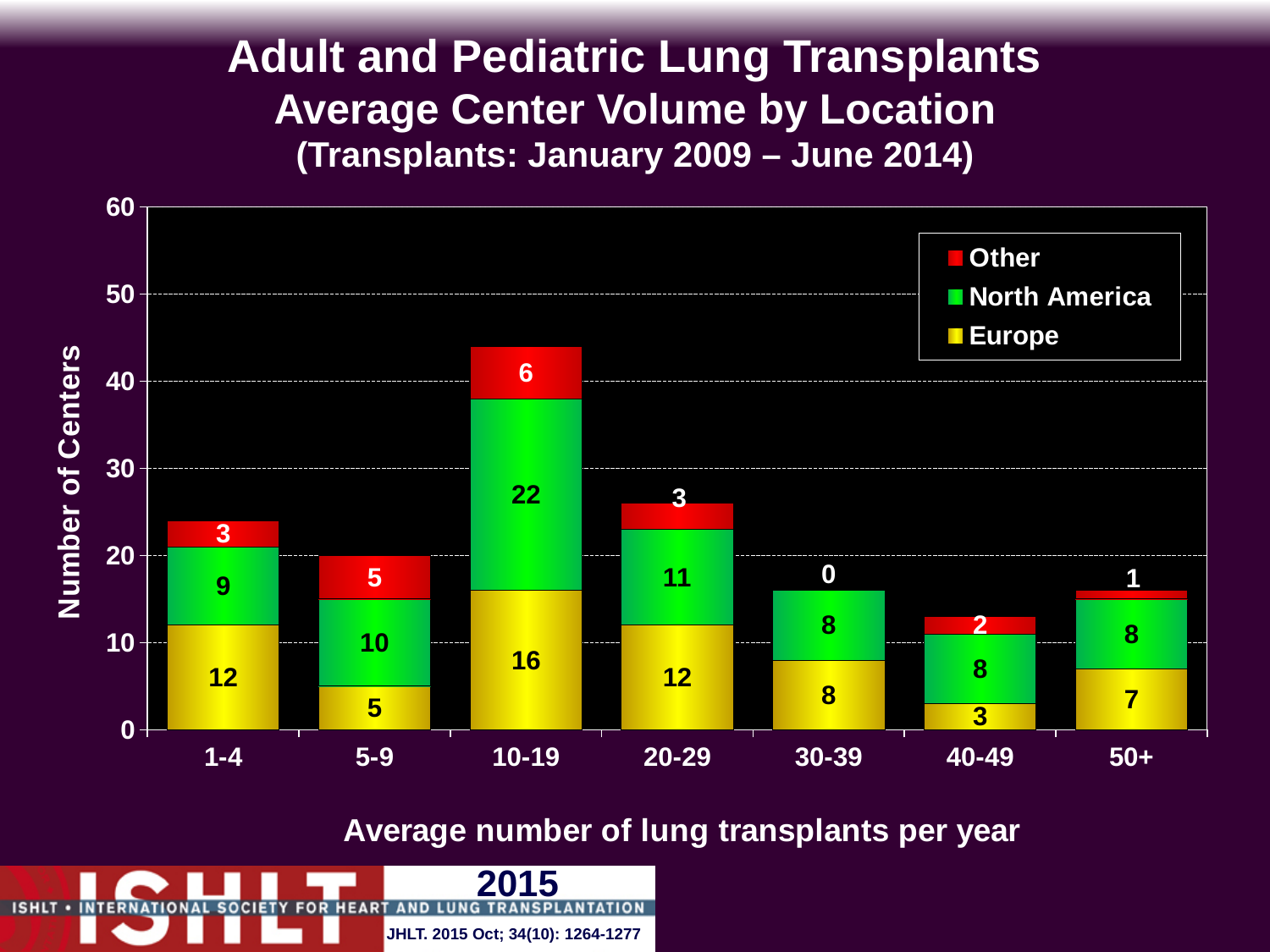
How many categories are shown on the x axis? 7 What is the total number of centers in the 20-29 category? 26 Which is larger, the Europe value for 50+ or the Europe value for 40-49? 50+ What is the Other value for the 5-9 category? 5 What is the total number of centers in the 10-19 category? 44 What is the difference between the Europe values for the 1-4 and 5-9 categories? 7 Which category has the lowest Other value? 30-39 What is the North America value for the 40-49 category? 8 What type of chart is shown on the slide? Stacked bar chart How many series does the legend list? 3 What is the Europe value for the 10-19 category? 16 Which category has the highest North America value? 10-19